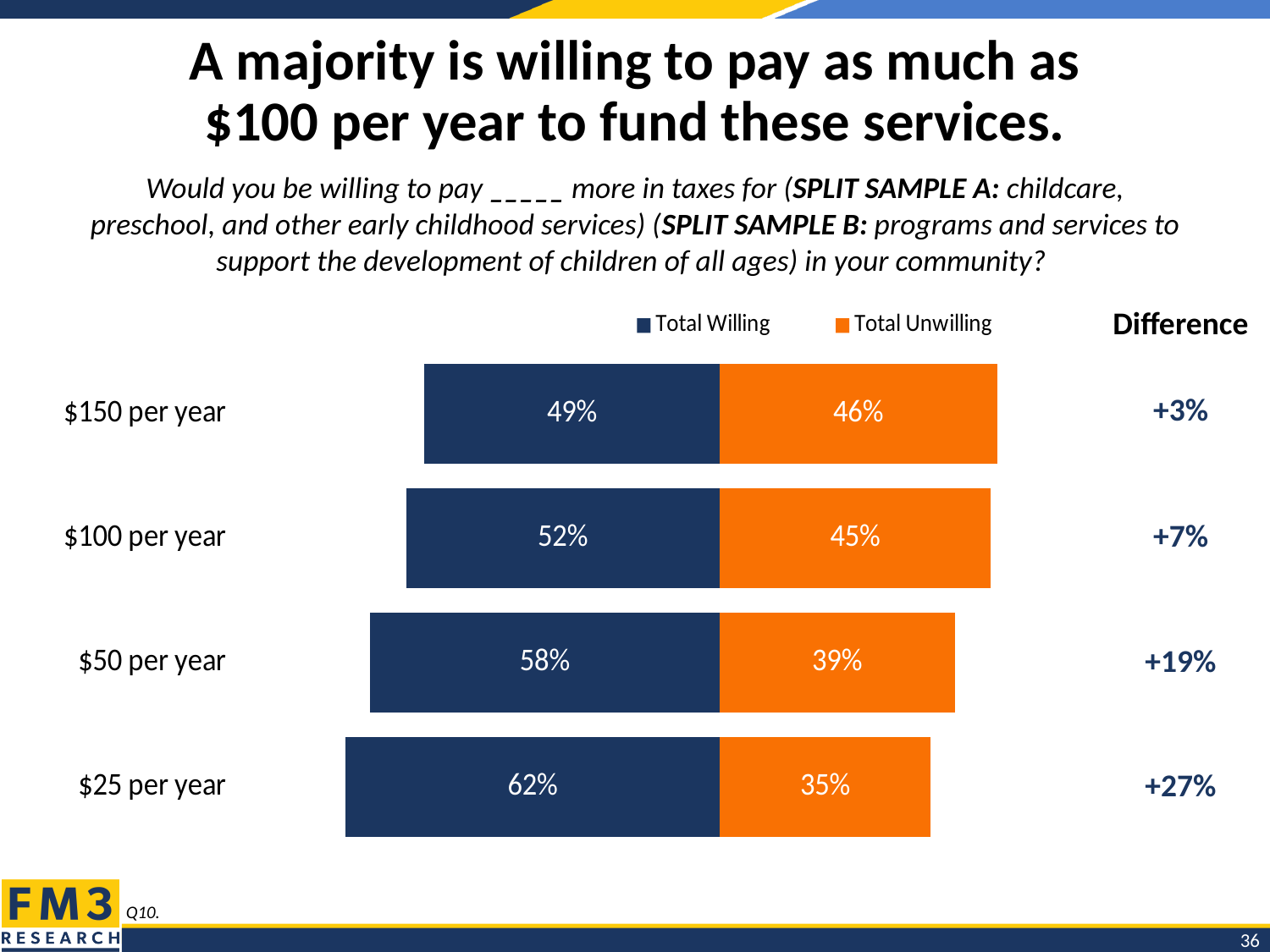
Does the Total Willing percentage rise or fall as the amount per year increases from $25 to $150? Fall What is the Total Willing value for $150 per year? 49% What percentage of respondents are willing to pay $100 per year? 52% How many amount categories are shown in the chart? 4 What is the difference between Total Willing and Total Unwilling for $50 per year? +19% Which amount per year has the lowest Total Unwilling percentage? $25 per year What kind of chart is shown on the slide? Stacked bar chart Which amount per year has the highest Total Willing percentage? $25 per year Is the Total Willing value larger for $100 per year or for $150 per year? $100 per year How many series does the legend list? 2 What is the Difference shown for $25 per year? +27% What is the Total Unwilling value for $50 per year? 39%